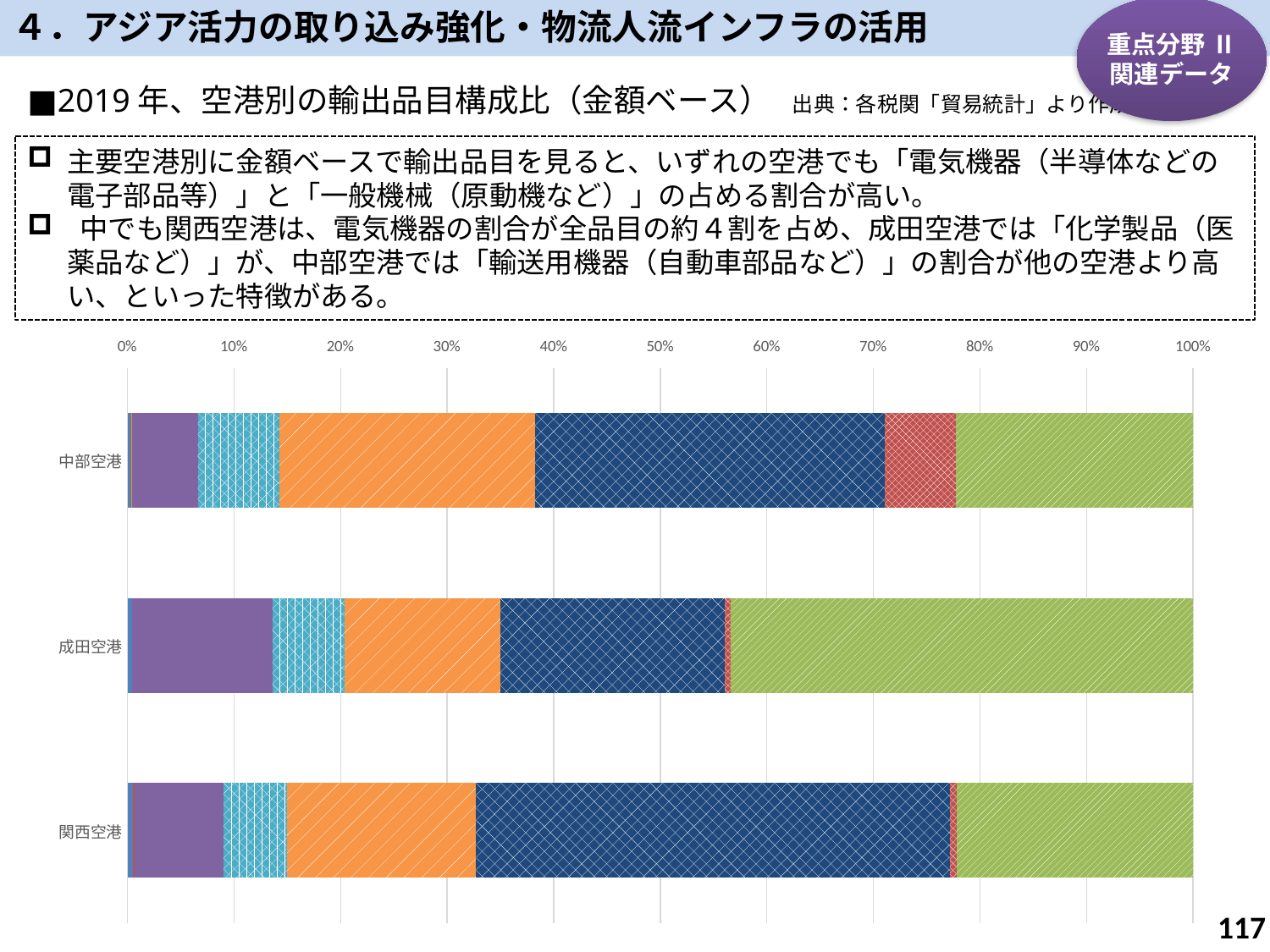
Is the right edge of the dark blue segment for 成田空港 greater or less than 60%? less What kind of chart is shown on the slide? Stacked bar chart Which airport has the smallest purple segment at the left of its bar? 中部空港 Is the right edge of the dark blue segment for 関西空港 greater or less than 70%? greater What is the title of the chart on the slide? 2019年、空港別の輸出品目構成比（金額ベース） Which airports are listed as categories on the chart's vertical axis? 中部空港, 成田空港, 関西空港 Which airport has the largest dark blue (cross-hatched) segment in its bar? 関西空港 Which airport has the largest green segment at the right end of its bar? 成田空港 How many airports (categories) are plotted on the chart? 3 Is the dark blue segment larger for 中部空港 or for 成田空港? 中部空港 Which airport has the largest red segment in its bar? 中部空港 Is the right edge of the purple segment for 成田空港 greater or less than 10%? greater